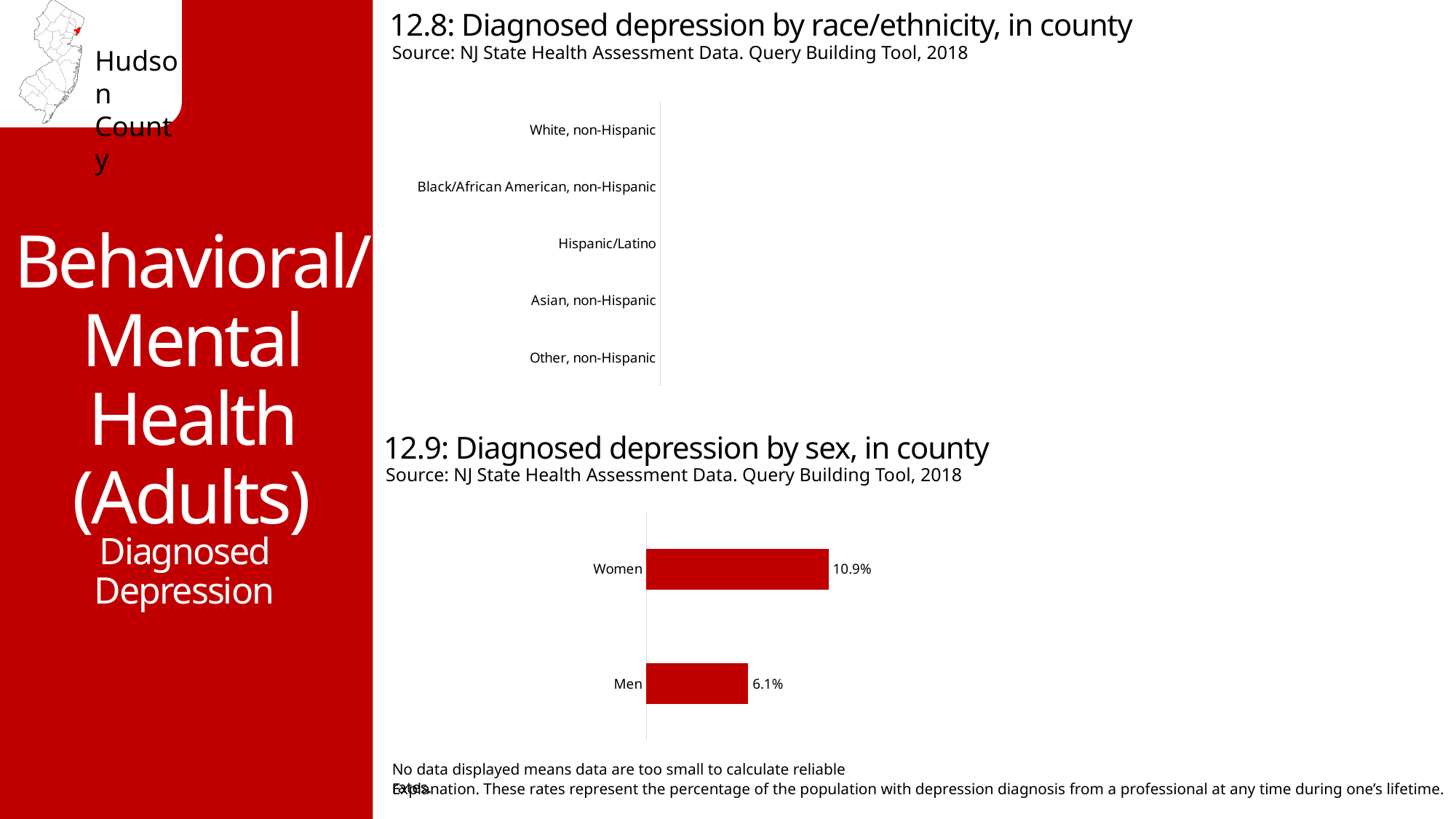
In the chart titled '12.9: Diagnosed depression by sex, in county', what is the value for Men? 6.1% In the chart titled '12.9: Diagnosed depression by sex, in county', which is larger, the value for Women or the value for Men? Women What is the source cited for the chart '12.9: Diagnosed depression by sex, in county'? NJ State Health Assessment Data. Query Building Tool, 2018 In the chart titled '12.8: Diagnosed depression by race/ethnicity, in county', are any bars or values displayed? No What kind of chart is '12.9: Diagnosed depression by sex, in county'? Bar chart In the chart titled '12.9: Diagnosed depression by sex, in county', what is the difference between the values for Women and Men? 4.8 percentage points In the chart titled '12.9: Diagnosed depression by sex, in county', what is the value for Women? 10.9% In the chart titled '12.9: Diagnosed depression by sex, in county', which category has the highest value? Women In the chart titled '12.9: Diagnosed depression by sex, in county', how many categories are plotted? 2 In the chart titled '12.8: Diagnosed depression by race/ethnicity, in county', how many race/ethnicity categories are listed? 5 In the chart titled '12.9: Diagnosed depression by sex, in county', which category has the lowest value? Men